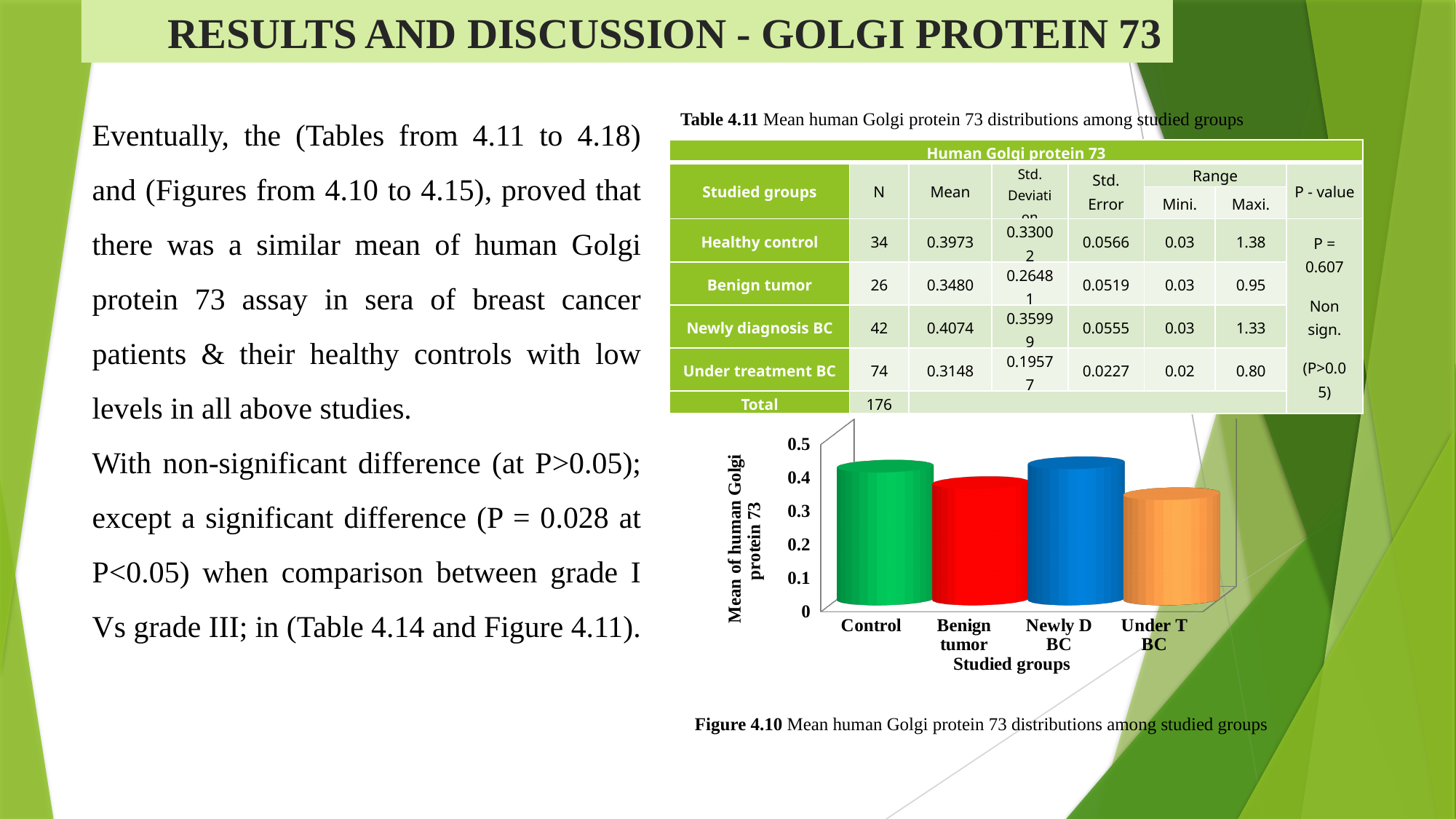
Is the value for Benign tumor greater or less than 0.4? less Is the value for Under T BC greater or less than 0.4? less How many studied groups are plotted in the chart? 4 Is the value for Control greater or less than 0.3? greater What is the label of the vertical axis of the chart? Mean of human Golgi protein 73 What kind of chart is shown in Figure 4.10? bar chart Which is larger in the chart, the value for Benign tumor or the value for Under T BC? Benign tumor Which is larger in the chart, the value for Control or the value for Under T BC? Control What colour is the bar for Newly D BC in the chart? blue Which studied group has the lowest bar in the chart? Under T BC